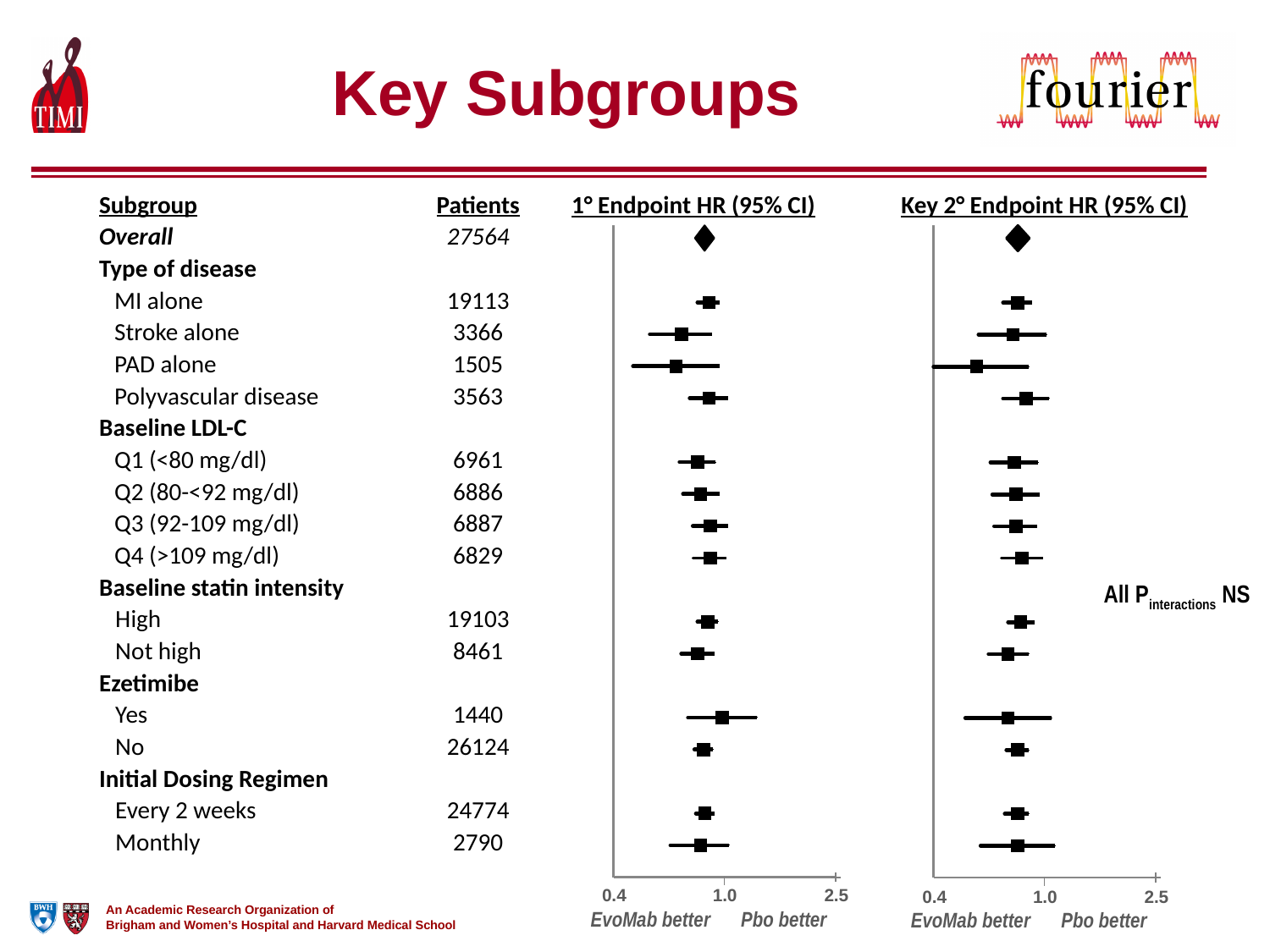
Which subgroup (excluding Overall) has the largest number of patients? No (Ezetimibe) How many subgroups are listed under Type of disease? 4 In the Key 2° Endpoint HR (95% CI) plot, is the hazard ratio for the Overall row greater or less than 1.0? less Which subgroup has the smallest number of patients? Yes (Ezetimibe) How many patients are in the Q3 (92-109 mg/dl) baseline LDL-C subgroup? 6887 How many patients are in the Monthly initial dosing regimen subgroup? 2790 What kind of chart is shown on the Key Subgroups slide? Forest plot How many patients are in the PAD alone subgroup? 1505 How many patients are in the Overall row of the Key Subgroups forest plot? 27564 Which subgroup has more patients, MI alone or Stroke alone? MI alone What is the difference in patient numbers between the Every 2 weeks and Monthly dosing subgroups? 21984 In the 1° Endpoint HR (95% CI) plot, is the hazard ratio for PAD alone greater or less than 1.0? less